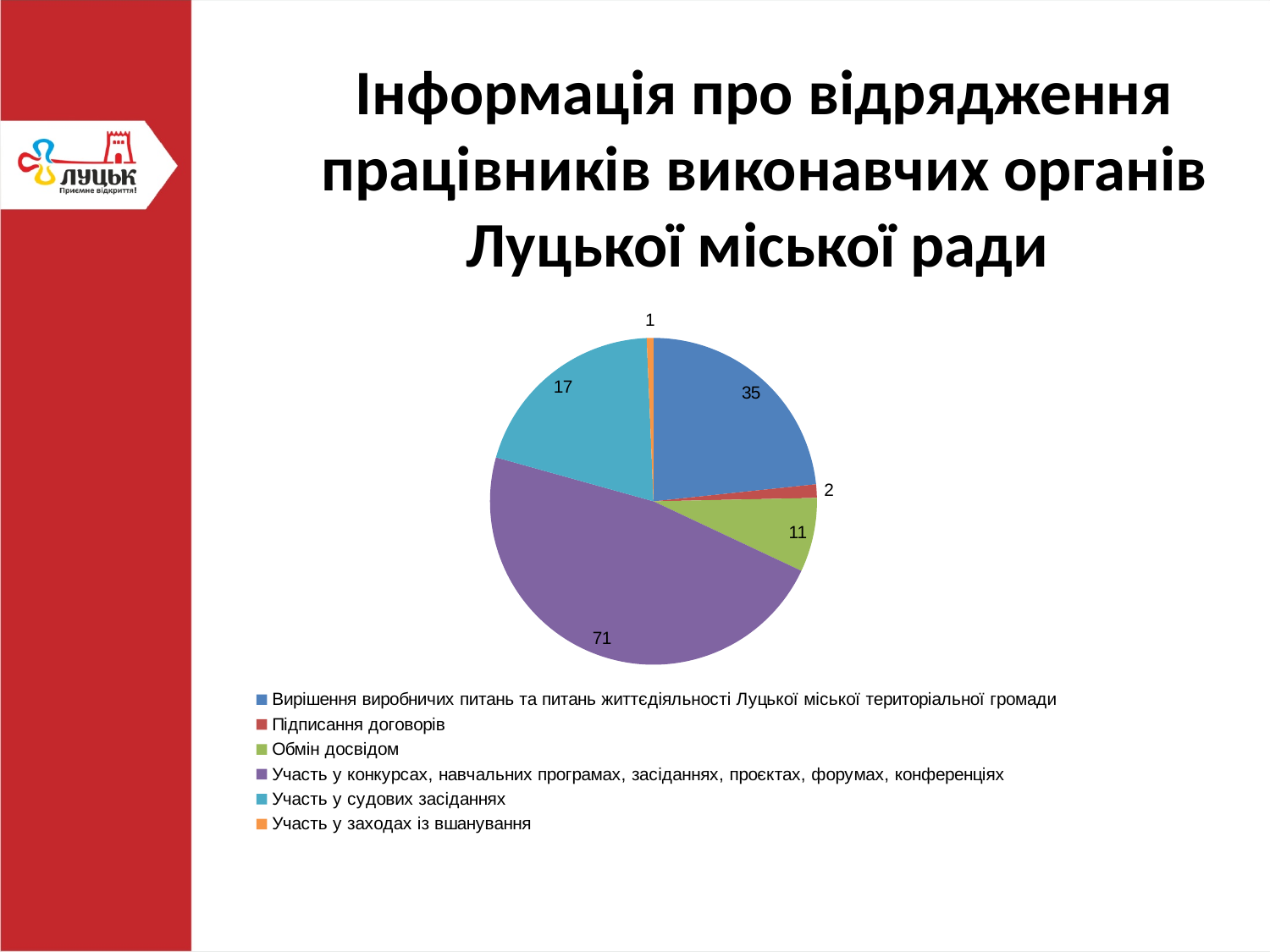
What is the difference between the value for "Участь у конкурсах, навчальних програмах, засіданнях, проєктах, форумах, конференціях" and the value for "Вирішення виробничих питань та питань життєдіяльності Луцької міської територіальної громади"? 36 What type of chart is shown on the slide? pie chart Which category has the largest slice of the pie? Участь у конкурсах, навчальних програмах, засіданнях, проєктах, форумах, конференціях What is the value for "Підписання договорів"? 2 How many entries does the legend list? 6 What is the value for "Участь у конкурсах, навчальних програмах, засіданнях, проєктах, форумах, конференціях"? 71 Which is larger: the value for "Участь у судових засіданнях" or the value for "Обмін досвідом"? Участь у судових засіданнях How many slices does the pie chart have? 6 Which category has the smallest slice of the pie? Участь у заходах із вшанування What is the value for "Участь у судових засіданнях"? 17 What colour is the slice for "Участь у судових засіданнях"? light blue (cyan) What is the value for "Обмін досвідом"? 11